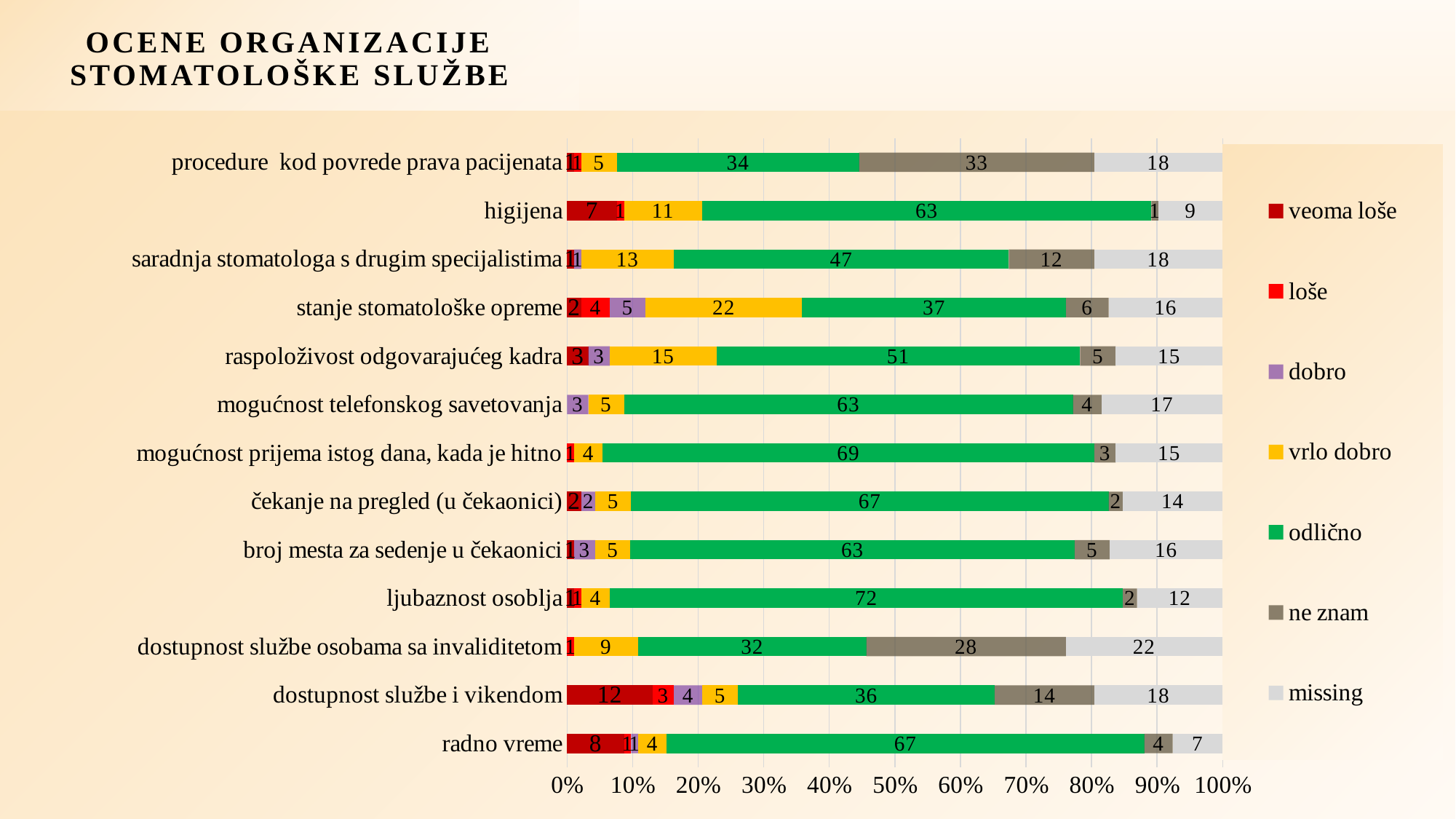
What is the 'odlično' value for 'ljubaznost osoblja'? 72 What is the 'missing' value for 'radno vreme'? 7 What kind of chart is shown on the slide? Stacked bar chart Which category has the lowest 'odlično' value? dostupnost službe osobama sa invaliditetom What is the difference between the 'odlično' values for 'higijena' and 'stanje stomatološke opreme'? 26 How many categories (rows) are plotted in the chart? 13 Which category has the highest 'odlično' value? ljubaznost osoblja Which has the larger 'missing' value: 'dostupnost službe osobama sa invaliditetom' or 'radno vreme'? dostupnost službe osobama sa invaliditetom What is the 'vrlo dobro' value for 'stanje stomatološke opreme'? 22 What is the 'veoma loše' value for 'dostupnost službe i vikendom'? 12 How many series does the legend list? 7 What is the 'ne znam' value for 'procedure kod povrede prava pacijenata'? 33